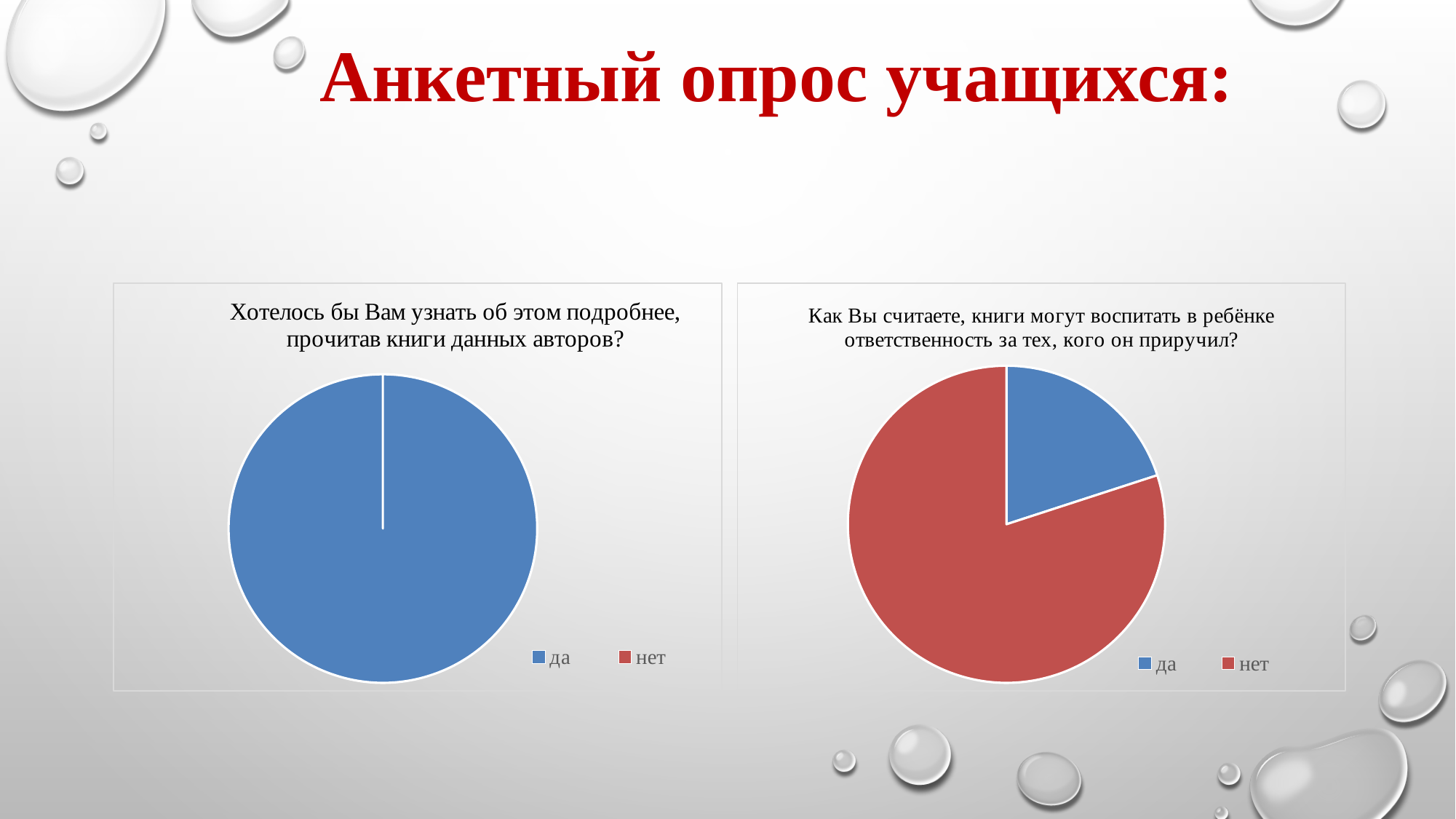
In the right chart, which answer has the smallest slice? да What is the title of the left chart? Хотелось бы Вам узнать об этом подробнее, прочитав книги данных авторов? In the left chart, which slice is larger, "да" or "нет"? да In the left chart, how many entries does the legend list? 2 In the right chart, what colour is the slice for "нет"? red In the right chart, how many entries does the legend list? 2 What kind of chart is the right chart on the slide? pie chart In the left chart ("Хотелось бы Вам узнать об этом подробнее, прочитав книги данных авторов?"), which answer has the largest slice? да In the right chart, which slice is larger, "да" or "нет"? нет In the right chart ("Как Вы считаете, книги могут воспитать в ребёнке ответственность за тех, кого он приручил?"), which answer has the largest slice? нет What kind of chart is the left chart on the slide? pie chart